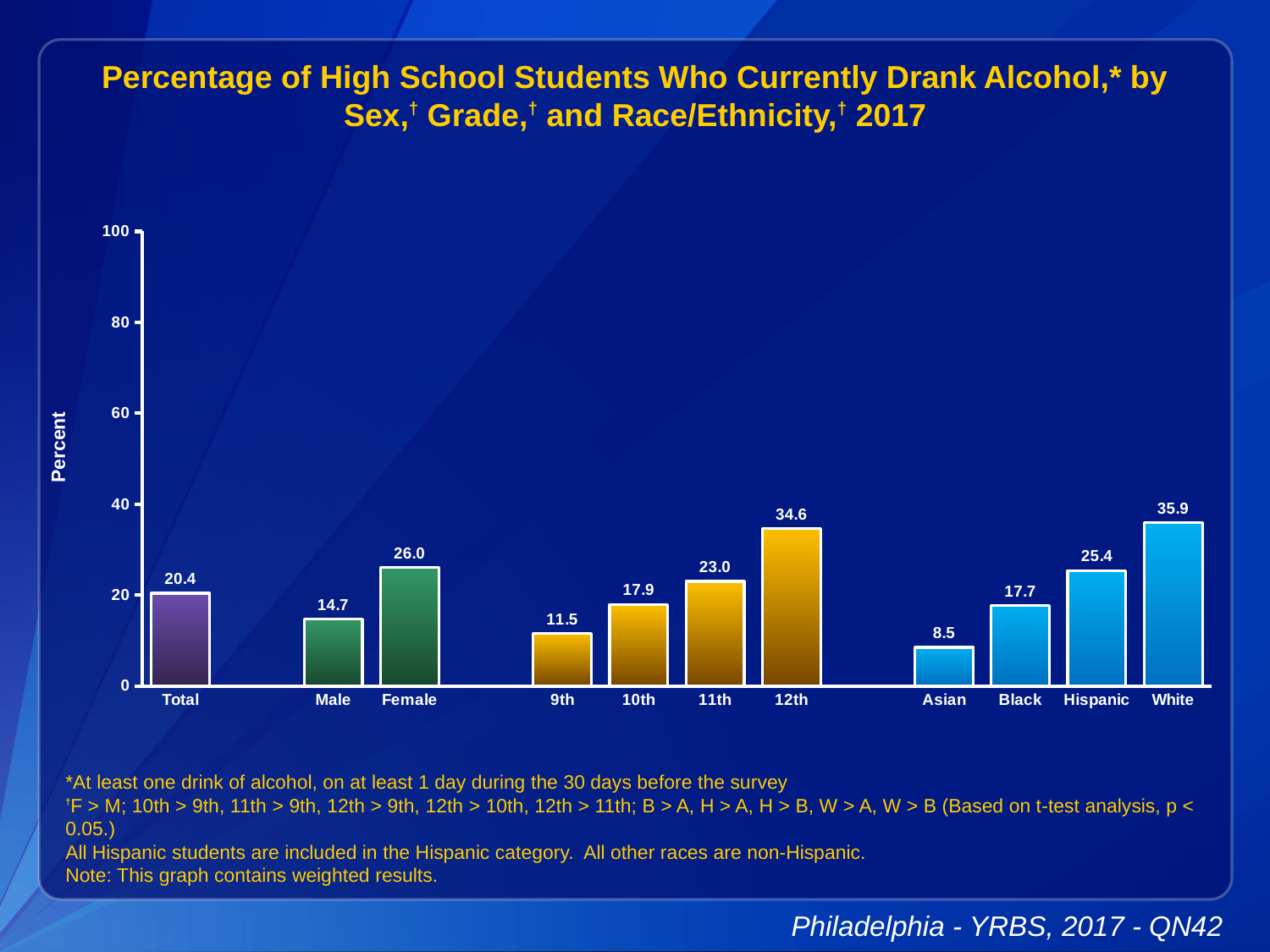
Is the value for 11th grade greater or less than 20? greater Which is larger, the value for Hispanic or the value for Black? Hispanic What is the value for Total? 20.4 How many bars are shown in the chart? 11 What is the difference between the Female and Male values? 11.3 What is the value for 12th grade? 34.6 What kind of chart is shown? bar chart What is the value for Female? 26.0 What is the value for Asian? 8.5 Do the values rise or fall from 9th grade to 12th grade? rise Which category has the lowest value? Asian Which category has the highest value? White